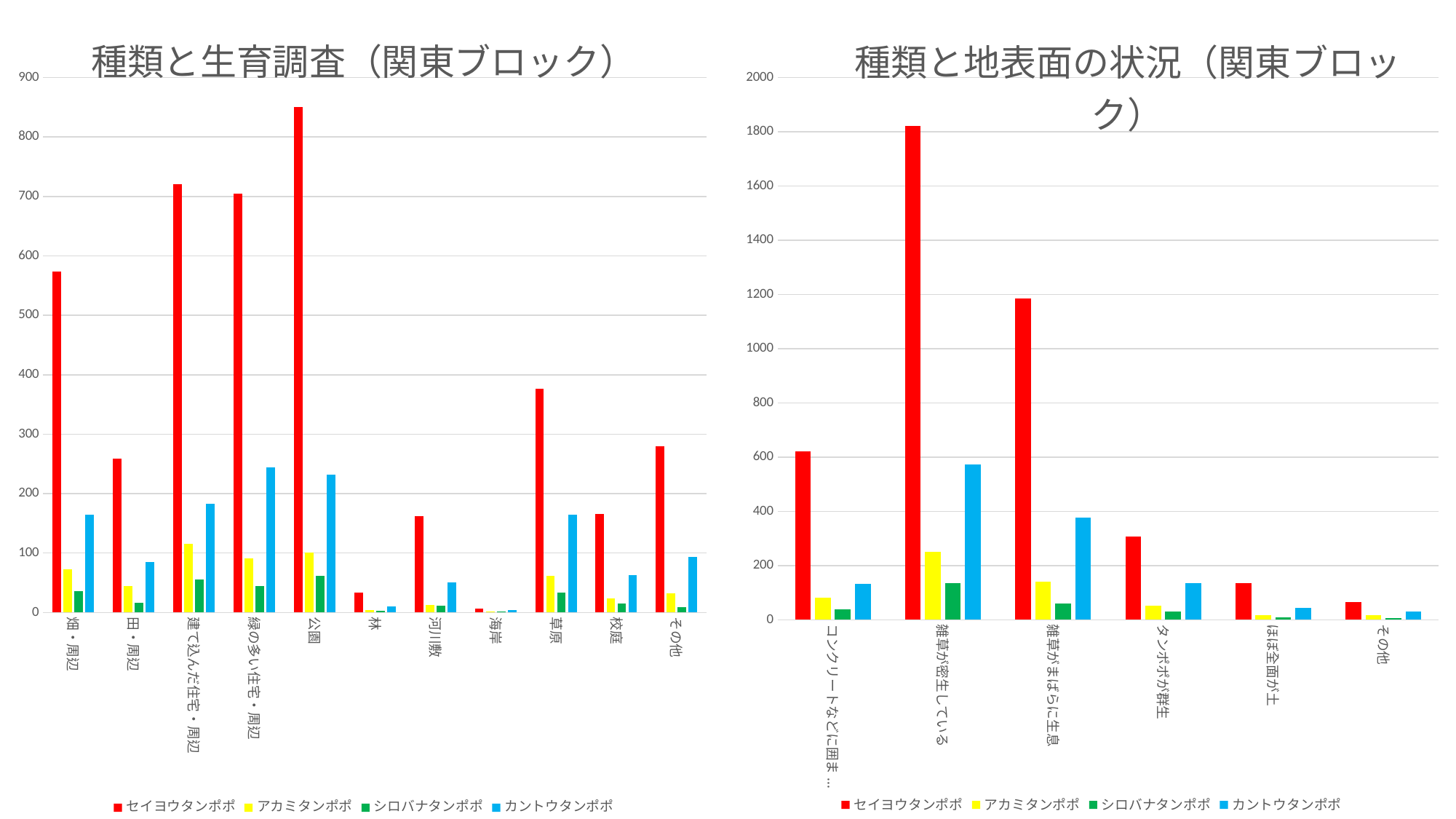
In the right chart 種類と地表面の状況（関東ブロック）, is the value for カントウタンポポ at 雑草が密生している greater or less than 400? greater How many categories are shown on the x axis of the right chart 種類と地表面の状況（関東ブロック）? 6 In the left chart 種類と生育調査（関東ブロック）, is the value for セイヨウタンポポ at 公園 greater or less than 800? greater In the left chart 種類と生育調査（関東ブロック）, which is larger for セイヨウタンポポ: 草原 or 校庭? 草原 In the right chart 種類と地表面の状況（関東ブロック）, which colour represents カントウタンポポ? blue In the left chart 種類と生育調査（関東ブロック）, which category has the lowest value for セイヨウタンポポ? 海岸 How many series does the legend of the right chart 種類と地表面の状況（関東ブロック） list? 4 How many categories are shown on the x axis of the left chart 種類と生育調査（関東ブロック）? 11 In the right chart 種類と地表面の状況（関東ブロック）, which category has the highest value for セイヨウタンポポ? 雑草が密生している In the right chart 種類と地表面の状況（関東ブロック）, is the value for セイヨウタンポポ at 雑草がまばらに生息 greater or less than 1000? greater What type of chart is the left chart titled 種類と生育調査（関東ブロック）? bar chart In the left chart 種類と生育調査（関東ブロック）, which category has the highest value for セイヨウタンポポ? 公園